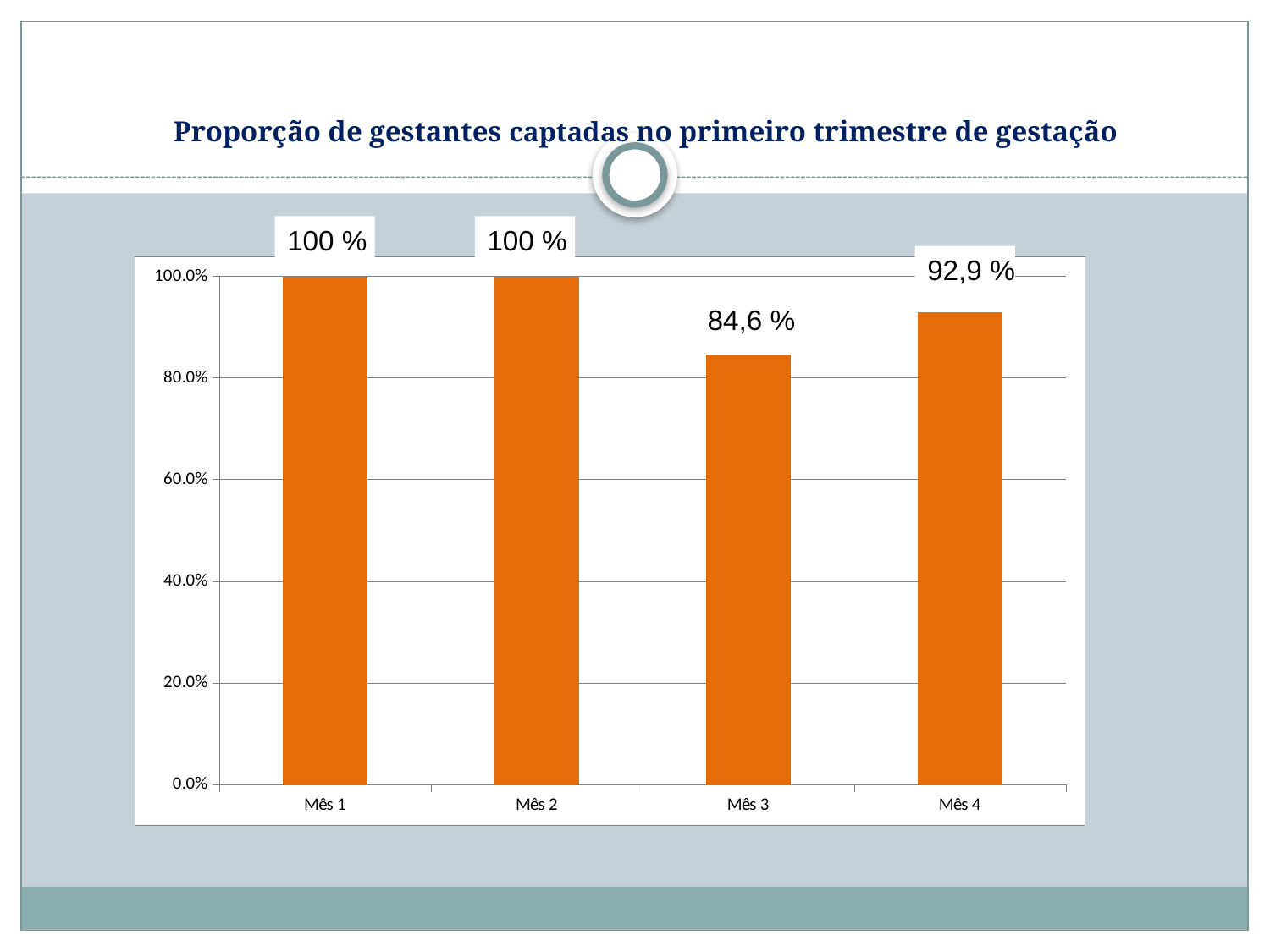
What is the value for Mês 3? 84,6 % What is the difference between the values for Mês 4 and Mês 3? 8,3 % What is the title of the chart? Proporção de gestantes captadas no primeiro trimestre de gestação What colour are the bars in the chart? orange Which month has the lowest value? Mês 3 How many months are shown on the x axis? 4 What is the value for Mês 4? 92,9 % Is the value for Mês 3 greater or less than 80.0%? greater What is the difference between the values for Mês 1 and Mês 4? 7,1 % What is the value for Mês 1? 100 % Which is larger, the value for Mês 3 or the value for Mês 4? Mês 4 What kind of chart is shown on the slide? bar chart